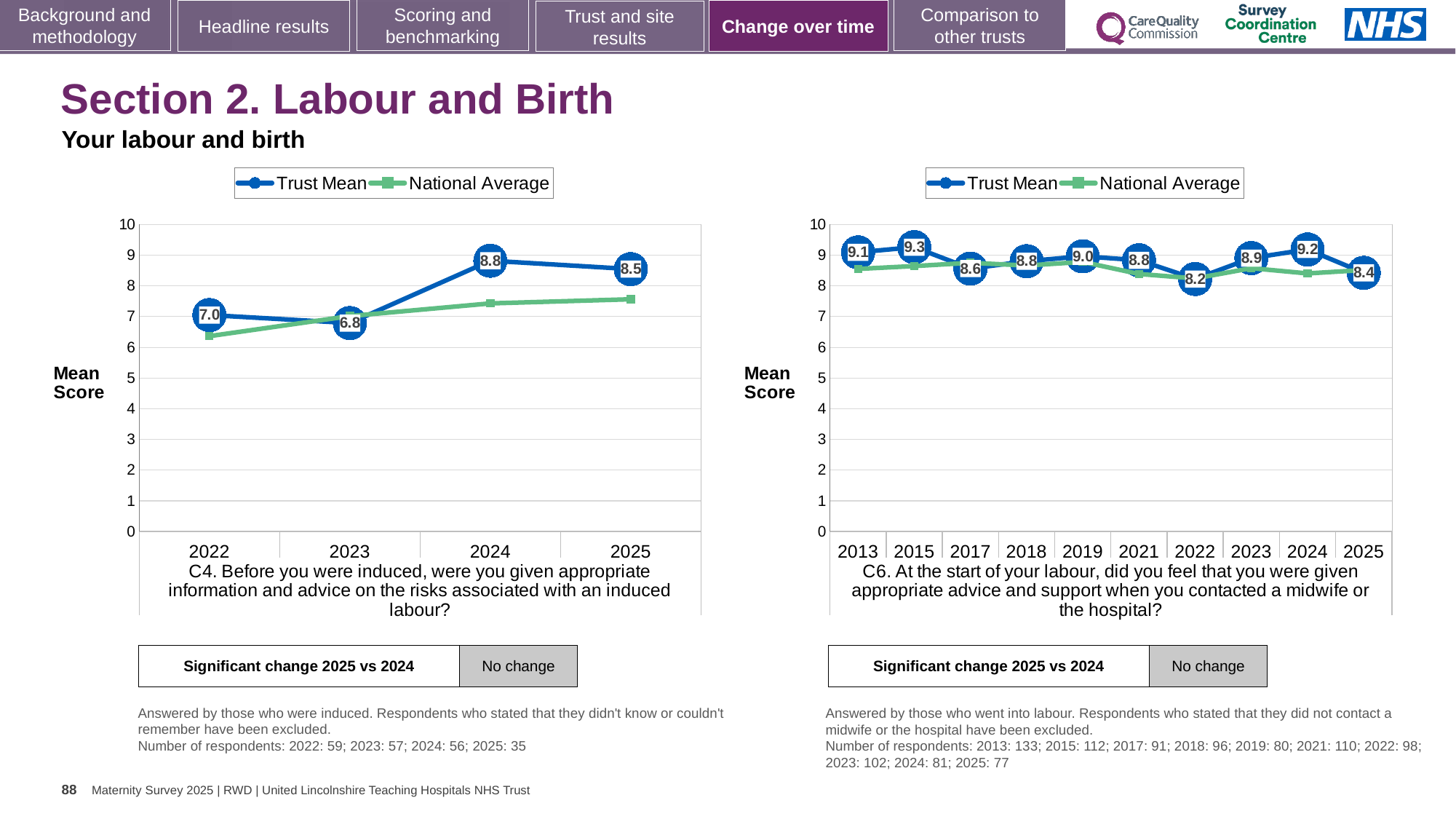
In the left chart (C4), what is the difference between the Trust Mean scores for 2024 and 2023? 2.0 In the right chart (C6), is the Trust Mean score for 2024 larger or smaller than the score for 2025? larger What kind of chart is the left chart (C4)? Line chart In the right chart (C6), how many years are shown on the x axis? 10 In the right chart (C6), which year has the lowest Trust Mean score? 2022 In the left chart (C4), which year has the lowest Trust Mean score? 2023 In the left chart (C4), what is the Trust Mean score for 2024? 8.8 In the left chart (C4), how many years are shown on the x axis? 4 In the left chart (C4), is the National Average for 2022 greater or less than 7? less In the right chart (C6), what is the Trust Mean score for 2022? 8.2 In the right chart (C6), which year has the highest Trust Mean score? 2015 How many series does the legend of the right chart (C6) list? 2